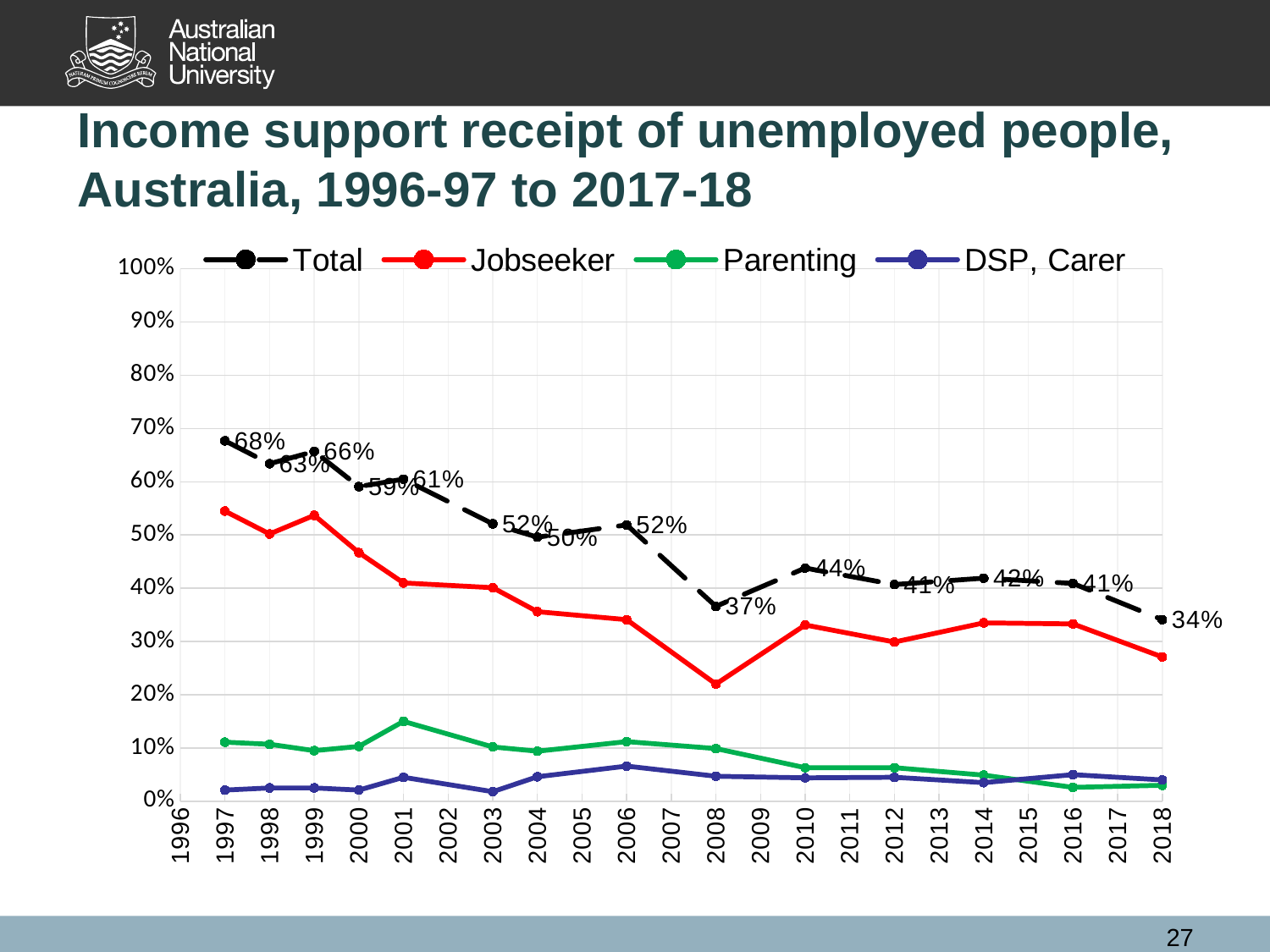
Does the Total series generally rise or fall from 1997 to 2018? fall In which year is the Total series at its lowest? 2018 Which series is drawn with a dashed line? Total What is the value of the Total series in 1997? 68% In which year is the Total series at its highest? 1997 Is the Jobseeker value in 1997 greater or less than 50%? greater Which is larger, the Total value in 2010 or the Total value in 2008? 2010 What type of chart is shown on the slide? line chart What is the difference between the Total value in 1997 and the Total value in 2018? 34% How many series does the legend list? 4 What is the value of the Total series in 2008? 37% What is the value of the Total series in 2018? 34%